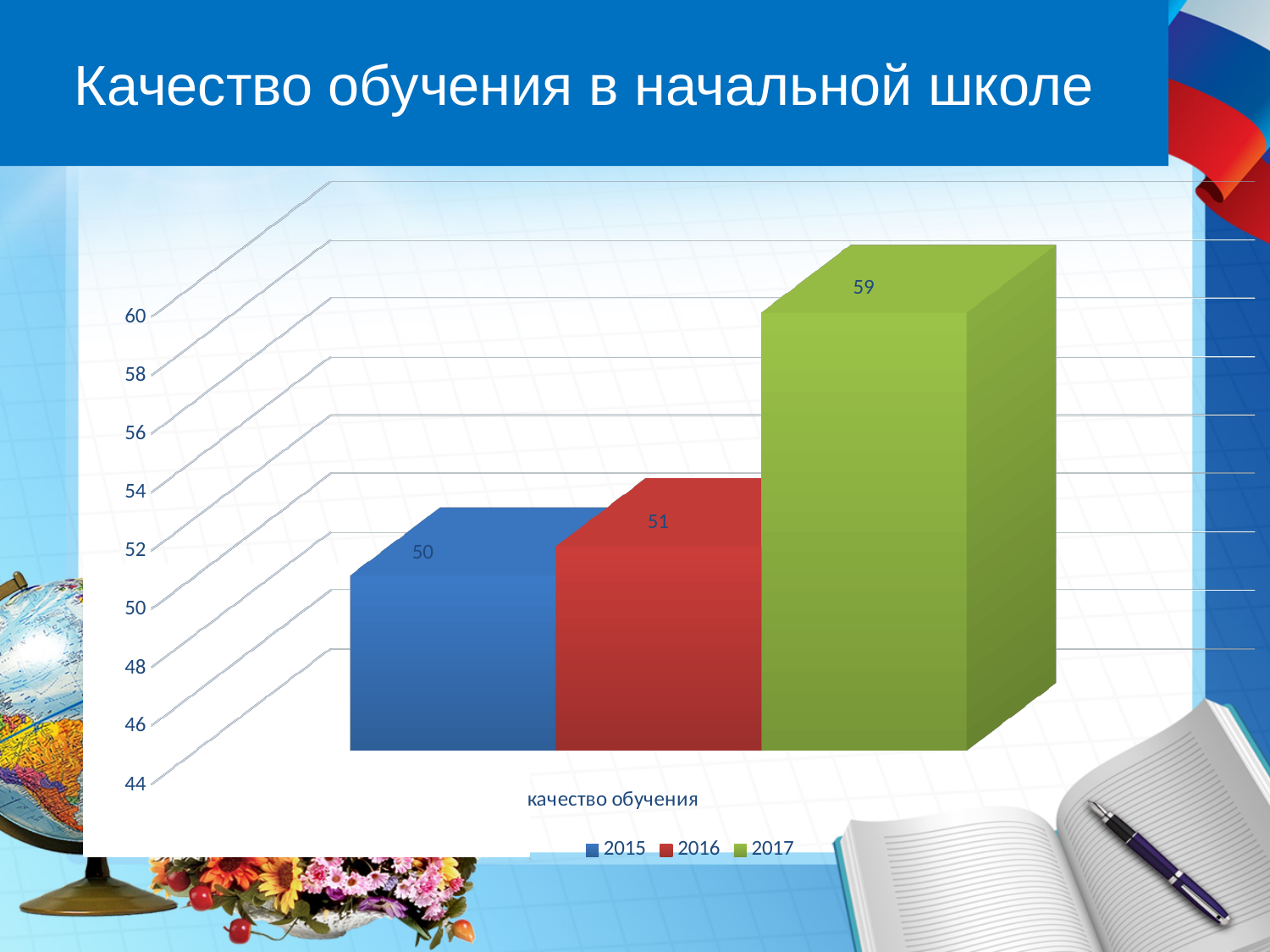
What kind of chart is shown on the slide? bar chart What is the value for 2017 in the chart? 59 Which year has the lowest value in the chart? 2015 What is the category label shown on the x axis of the chart? качество обучения What is the value for 2015 in the chart? 50 How many series does the legend list? 3 What is the value for 2016 in the chart? 51 Which year has the highest value in the chart? 2017 Do the values rise or fall from 2015 to 2017? rise What is the difference between the values for 2017 and 2016? 8 Which is larger, the value for 2017 or the value for 2016? 2017 What is the difference between the values for 2017 and 2015? 9